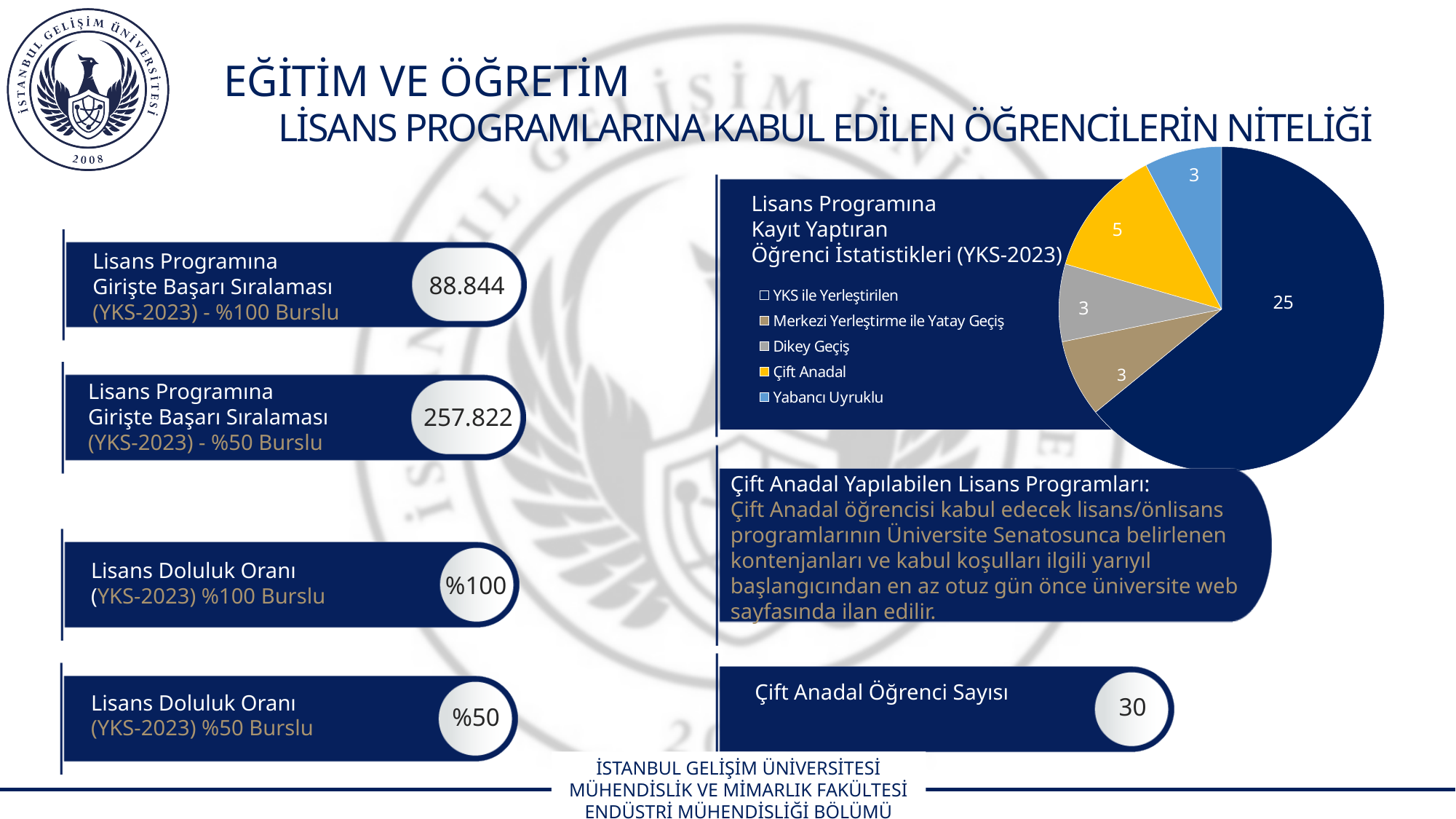
How many categories does the pie chart have? 5 What is the value for Dikey Geçiş in the pie chart? 3 What kind of chart is shown on the slide? pie chart What is the value for YKS ile Yerleştirilen in the pie chart? 25 What is the value for Yabancı Uyruklu in the pie chart? 3 What is the title of the pie chart? Lisans Programına Kayıt Yaptıran Öğrenci İstatistikleri (YKS-2023) What is the difference between the values for YKS ile Yerleştirilen and Çift Anadal in the pie chart? 20 What is the value for Çift Anadal in the pie chart? 5 Which category has the largest slice in the pie chart? YKS ile Yerleştirilen Which is larger in the pie chart, Çift Anadal or Merkezi Yerleştirme ile Yatay Geçiş? Çift Anadal What is the total of all the values shown in the pie chart? 39 Which legend entry in the pie chart is shown in yellow? Çift Anadal